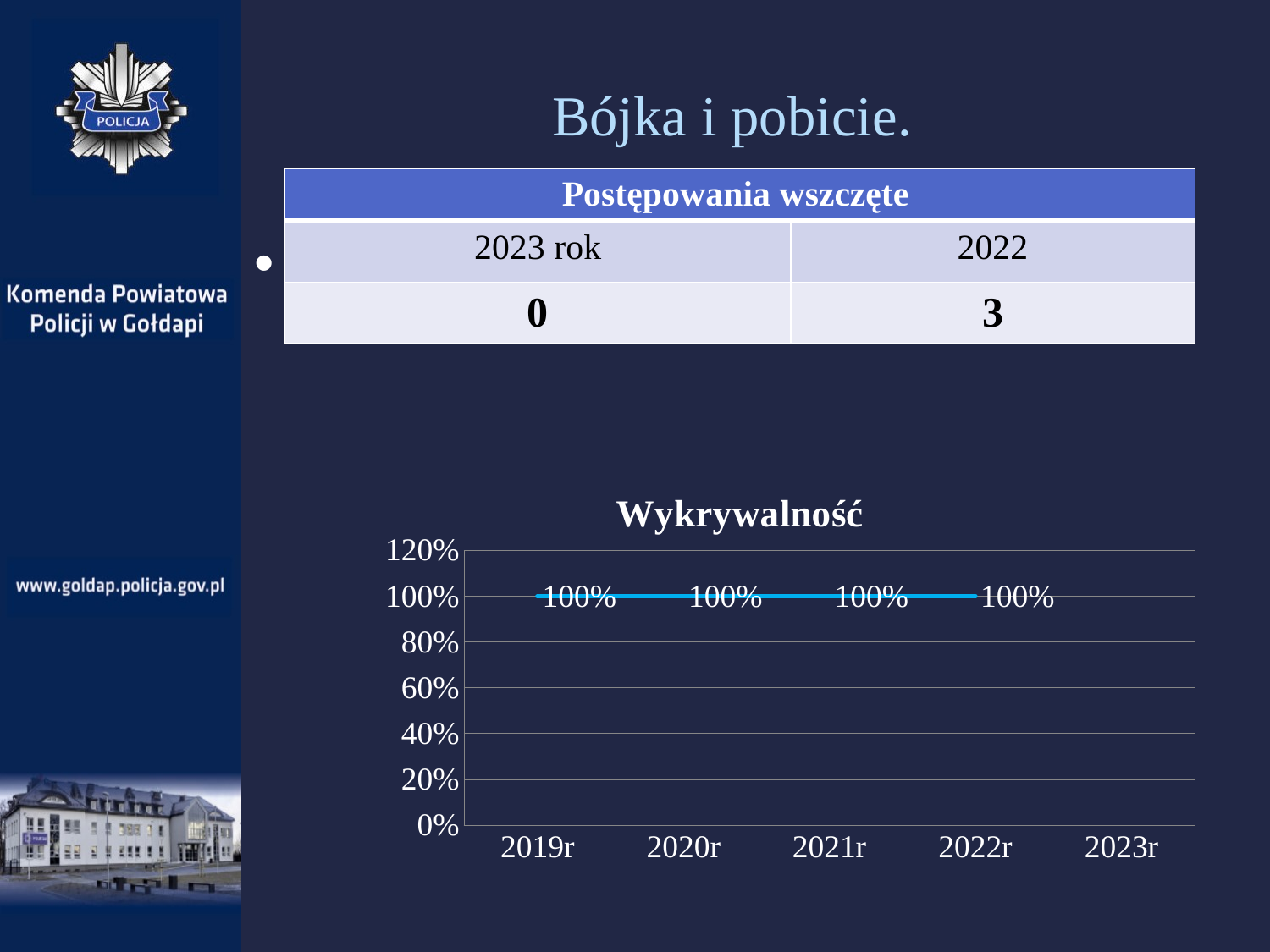
What is the value for 2021r in the Wykrywalność chart? 100% Do the values in the Wykrywalność chart rise, fall or stay flat from 2019r to 2022r? stay flat What is the difference between the values for 2019r and 2022r in the Wykrywalność chart? 0% How many year labels are shown on the x axis of the Wykrywalność chart? 5 What is the highest tick shown on the y axis of the Wykrywalność chart? 120% What is the value for 2020r in the Wykrywalność chart? 100% What kind of chart is the Wykrywalność chart? line chart What is the value for 2019r in the Wykrywalność chart? 100% Is the value for 2021r in the Wykrywalność chart greater or less than 80%? greater What is the value for 2022r in the Wykrywalność chart? 100% How many data points with a printed value are plotted in the Wykrywalność chart? 4 What is the title of the chart on the slide? Wykrywalność